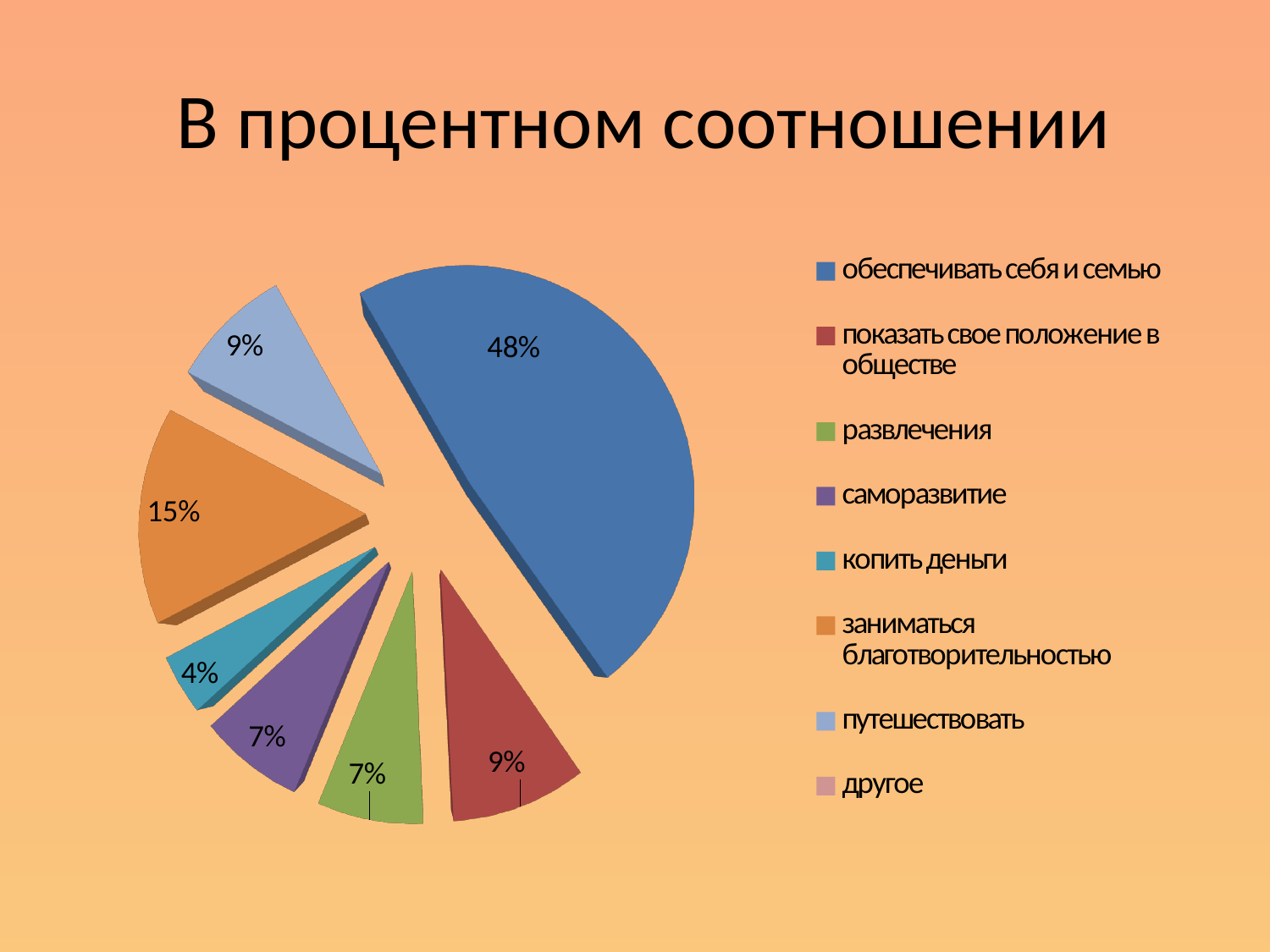
Which category with a visible slice has the smallest share of the pie? копить деньги Which category has the largest share of the pie? обеспечивать себя и семью What percentage is shown for "обеспечивать себя и семью"? 48% What percentage is shown for "путешествовать"? 9% What percentage is shown for "копить деньги"? 4% What colour is the slice for "саморазвитие"? purple What is the difference between the shares for "обеспечивать себя и семью" and "заниматься благотворительностью"? 33% What kind of chart is shown on the slide? pie chart What percentage is shown for "заниматься благотворительностью"? 15% What is the title of the chart? В процентном соотношении Which is larger: the share for "показать свое положение в обществе" or the share for "развлечения"? показать свое положение в обществе How many entries does the legend list? 8